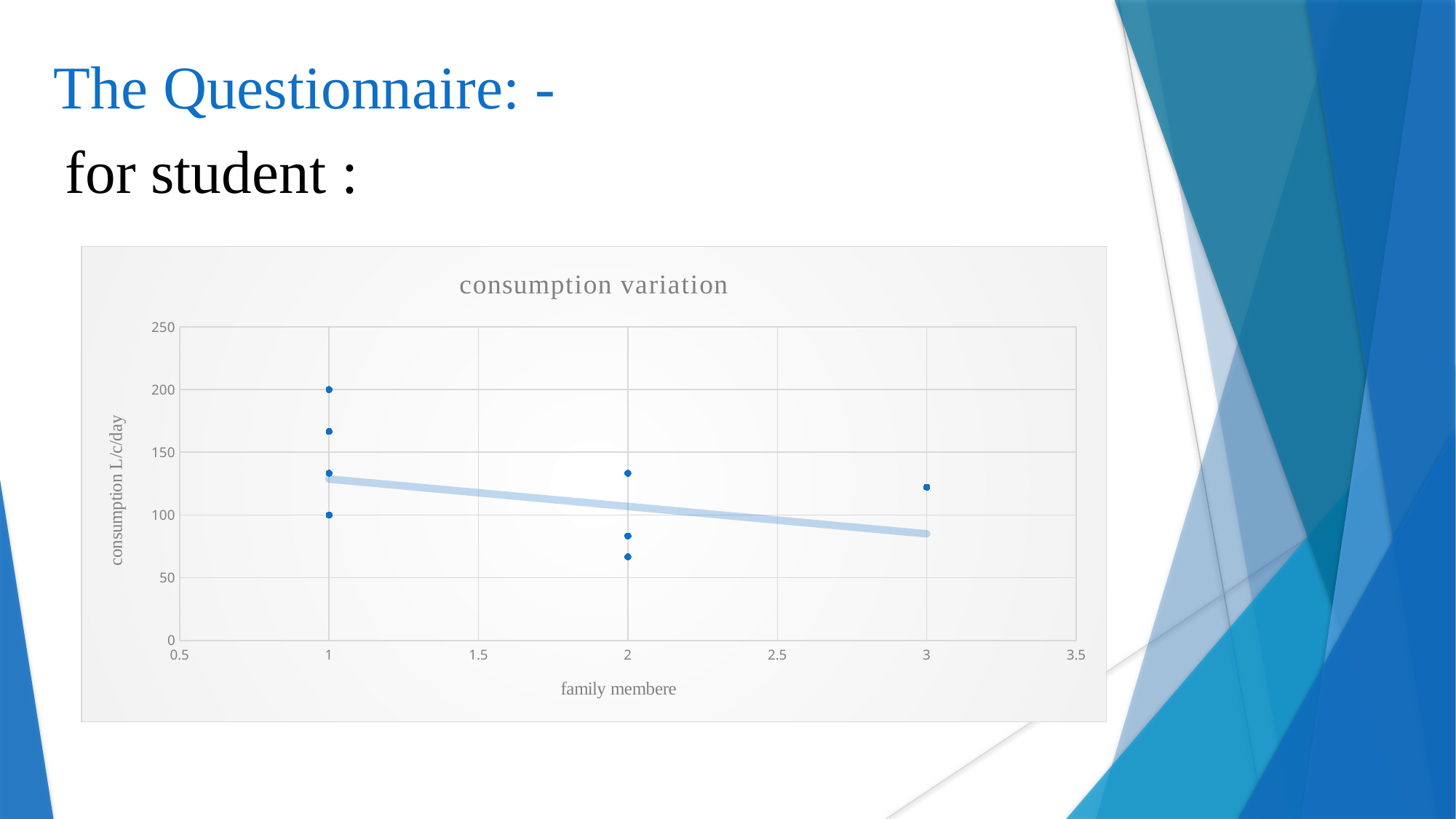
Which has the higher maximum plotted consumption value: 1 family member or 3 family members? 1 family member What is the highest consumption value plotted in the chart? 200 How many distinct family member values have data points plotted? 3 Does the trend line in the chart rise or fall as family members increase? fall Is the consumption value for 3 family members greater or less than 100? greater At which family member value is the highest consumption point plotted? 1 What kind of chart is shown on the slide? scatter chart Is the highest consumption value plotted for 2 family members greater or less than 150? less What is the label of the y axis of the chart? consumption L/c/day Is the lowest consumption value plotted for 2 family members greater or less than 100? less What is the title of the chart? consumption variation